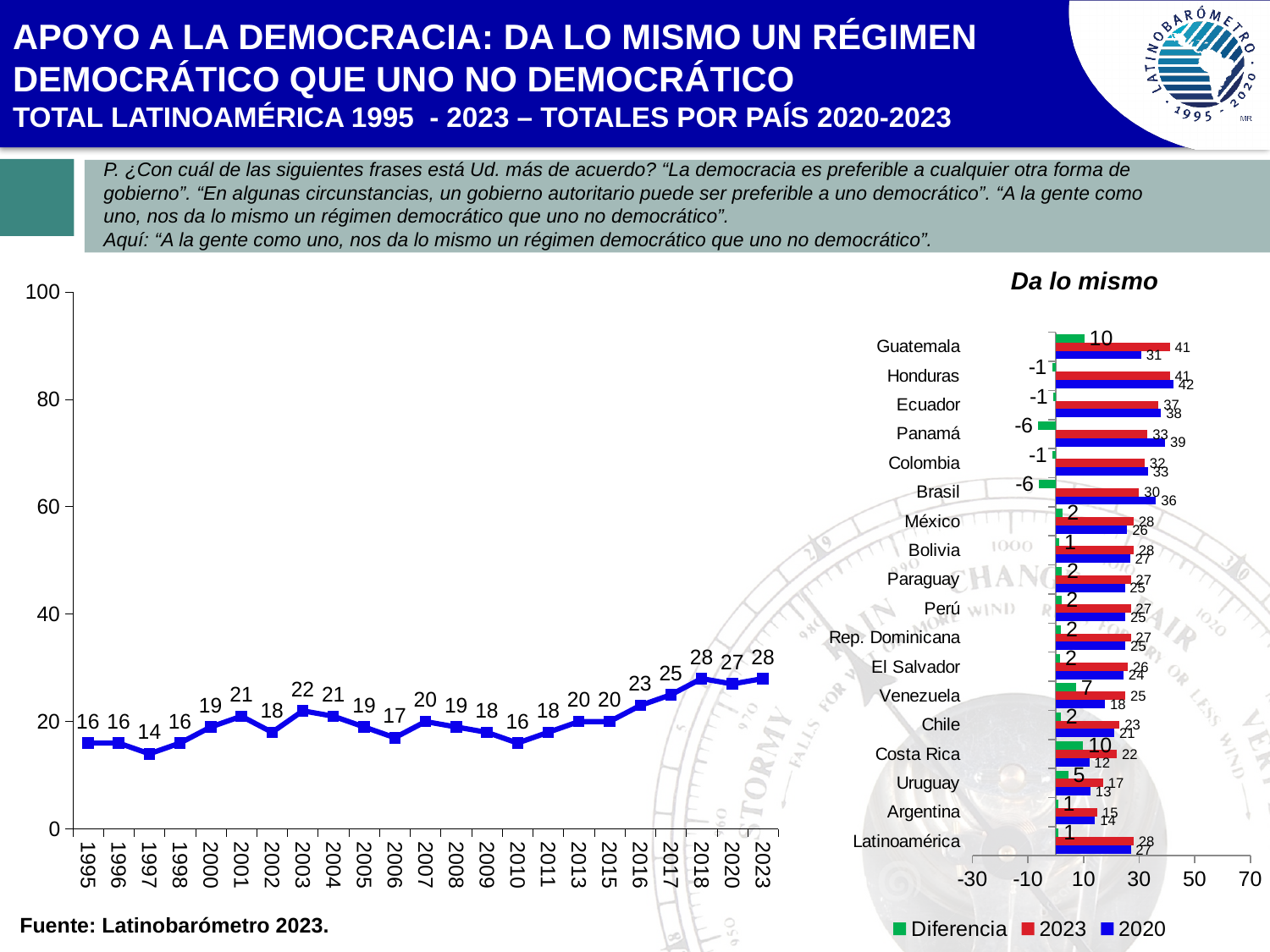
In the line chart on the left, what is the value for 2023? 28 In the line chart on the left, which year has the lowest value? 1997 In the 'Da lo mismo' bar chart, what is the 2020 value for Venezuela? 18 In the 'Da lo mismo' bar chart, what is the 2023 value for Panamá? 33 In the 'Da lo mismo' bar chart, how many series does the legend list? 3 What kind of chart is the 'Da lo mismo' chart on the right? bar chart In the 'Da lo mismo' bar chart, which country has the lowest 2023 value? Argentina In the line chart on the left, do the values rise or fall between 2010 and 2018? rise In the line chart on the left, how many data points are plotted? 23 In the 'Da lo mismo' bar chart, which is larger: the 2023 value for Brasil or the 2023 value for Chile? Brasil In the line chart on the left, what is the difference between the values for 2017 and 2010? 9 In the 'Da lo mismo' bar chart, which country has the highest 2020 value? Honduras